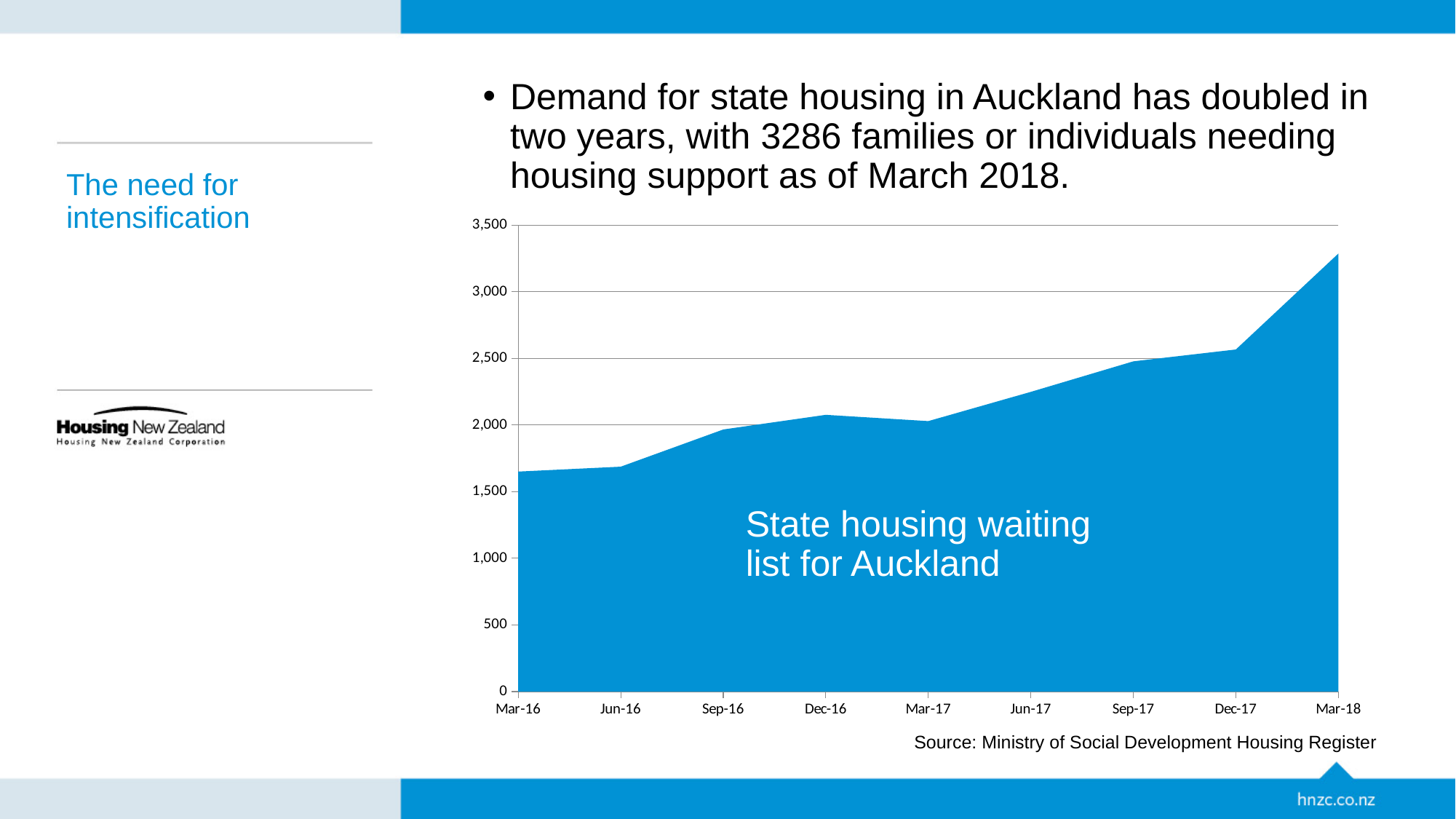
Overall, do the values rise or fall from Mar-16 to Mar-18? Rise Is the value for Mar-16 greater or less than 2,000? less How many time points are shown along the x axis of the chart? 9 Which is larger, the value for Sep-16 or the value for Jun-17? Jun-17 What is the title shown on the chart? State housing waiting list for Auckland Which time point has the highest value on the chart? Mar-18 Is the value for Mar-16 greater or less than 1,500? greater Which is larger, the value for Mar-16 or the value for Mar-18? Mar-18 What kind of chart is shown on the slide? Area chart Is the value for Mar-18 greater or less than 3,000? greater What source is cited below the chart? Ministry of Social Development Housing Register